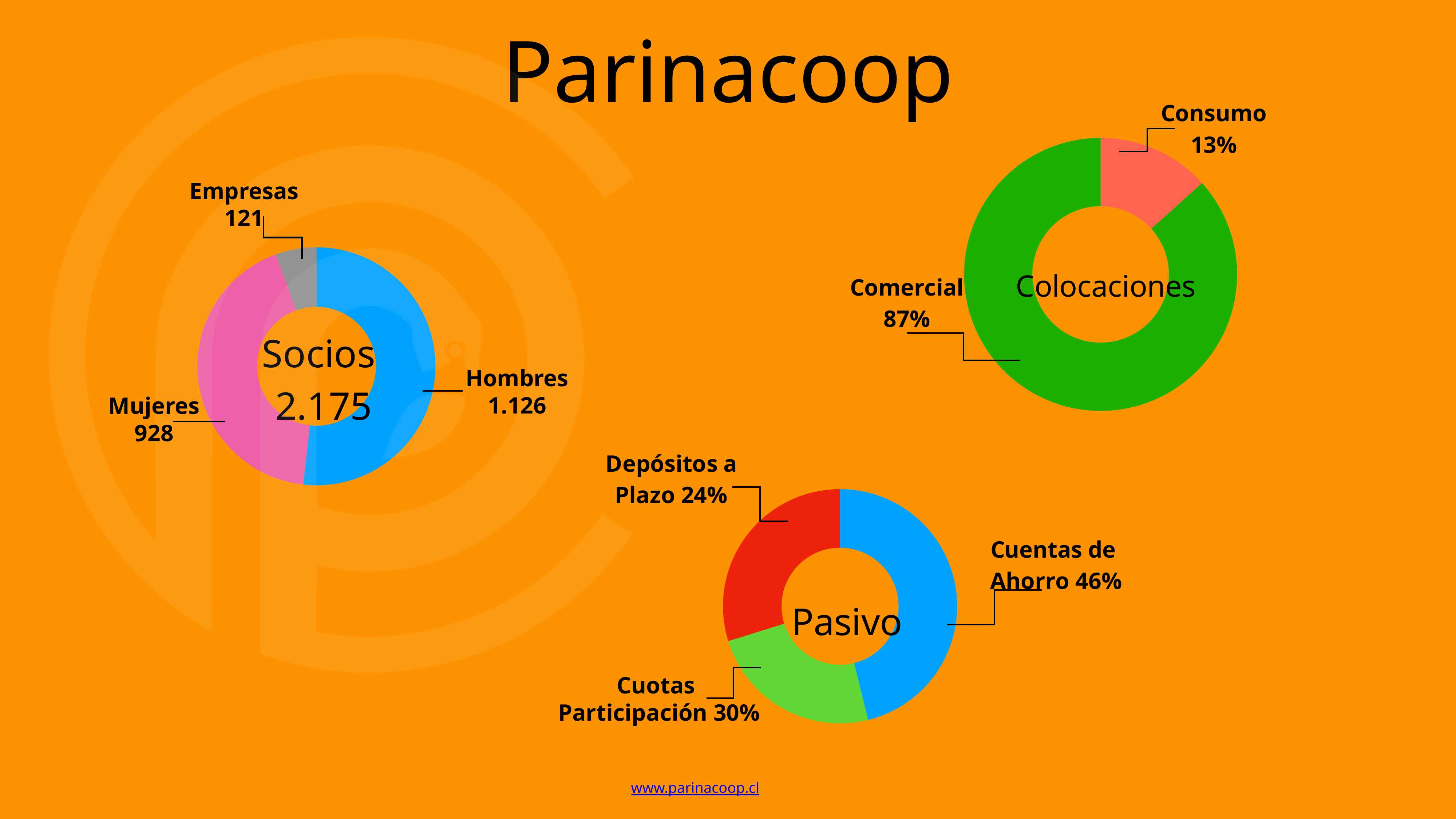
How many categories does the Socios chart show? 3 In the Pasivo chart, which category has the largest share? Cuentas de Ahorro In the Pasivo chart, what share does Cuotas Participación have? 30% In the Socios chart, what is the value for Mujeres? 928 What type of chart is the Pasivo chart? Donut (pie) chart In the Colocaciones chart, what share does Comercial have? 87% In the Socios chart, what is the difference between Hombres and Mujeres? 198 In the Colocaciones chart, which category is larger, Comercial or Consumo? Comercial In the Pasivo chart, what is the difference between Cuentas de Ahorro and Depósitos a Plazo? 22% In the Socios chart, what total is shown in the centre of the donut? 2.175 In the Socios chart, what is the value for Hombres? 1.126 In the Socios chart, which category has the smallest value? Empresas